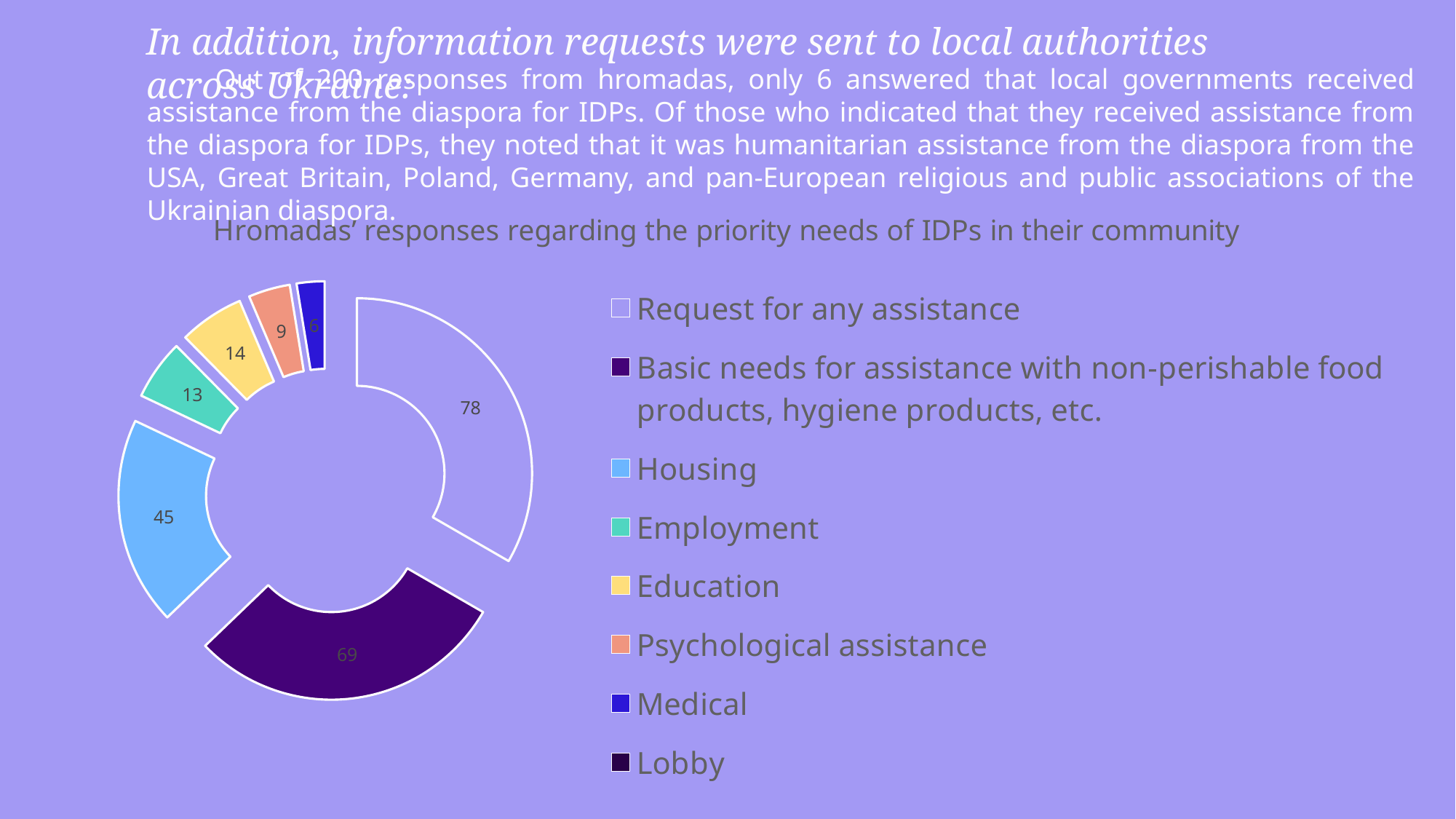
Which has the larger value, Education or Employment? Education What is the value for Request for any assistance? 78 What is the value for Housing? 45 What is the value for Employment? 13 What is the value for Basic needs for assistance with non-perishable food products, hygiene products, etc.? 69 What is the difference between the values for Request for any assistance and Basic needs for assistance with non-perishable food products, hygiene products, etc.? 9 What is the value for Psychological assistance? 9 Which category has the highest value? Request for any assistance What type of chart is shown on the slide? Doughnut chart How many entries does the chart legend list? 8 What is the value for Medical? 6 What is the title of the chart? Hromadas’ responses regarding the priority needs of IDPs in their community